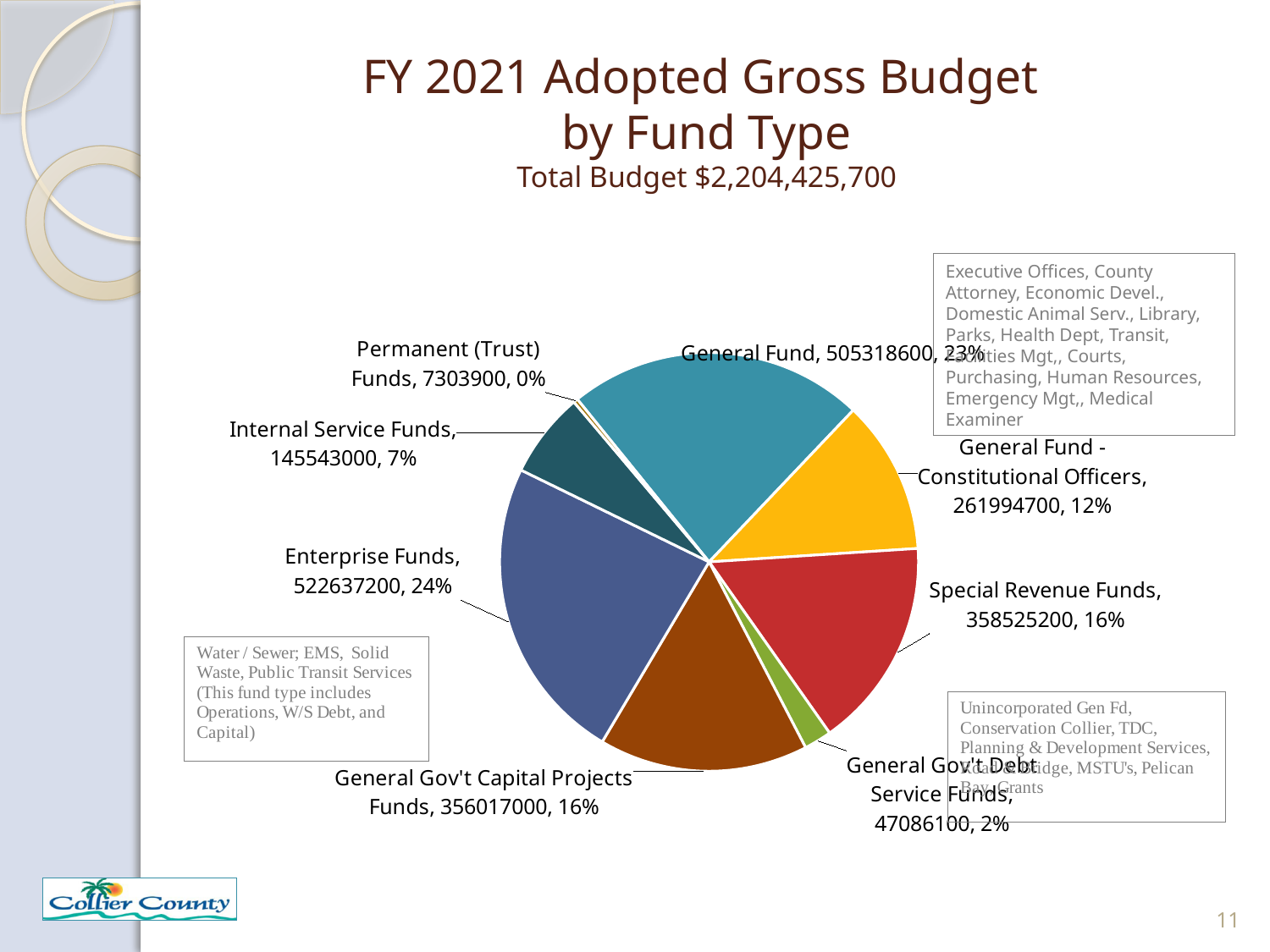
What is the value for Enterprise Funds? 522637200 Which fund type has the smallest value? Permanent (Trust) Funds What total budget is stated in the chart title? $2,204,425,700 What is the value for Special Revenue Funds? 358525200 What is the value for General Gov't Debt Service Funds? 47086100 What share of the pie does the General Fund slice represent? 23% What is the difference between the General Fund value and the General Fund - Constitutional Officers value? 243323900 What type of chart is shown on the slide? Pie chart Which is larger, Special Revenue Funds or General Gov't Capital Projects Funds? Special Revenue Funds How many fund types (slices) are shown in the pie chart? 8 Which fund type has the largest value? Enterprise Funds What percentage share is shown for Internal Service Funds? 7%